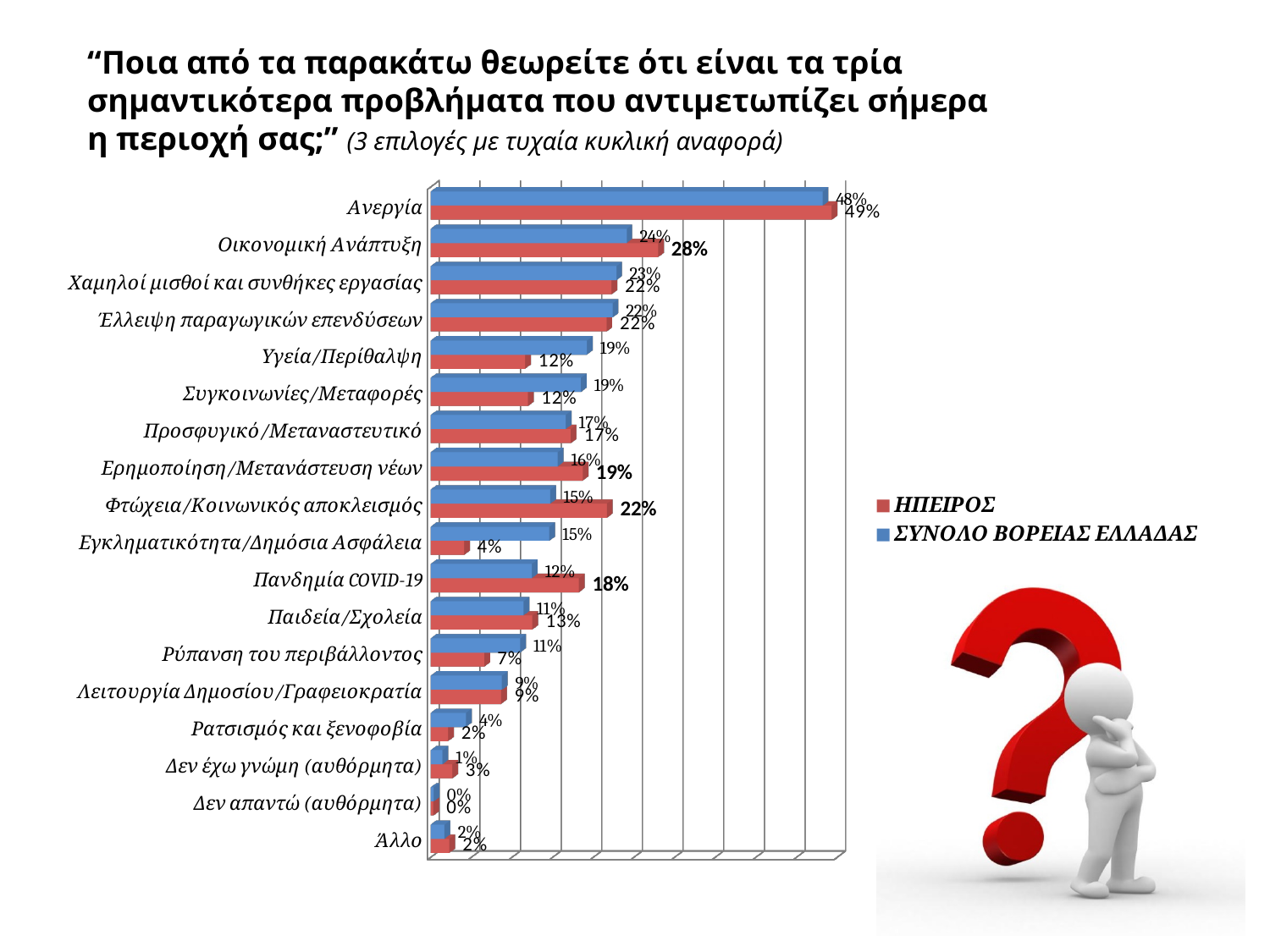
What is the value for ΗΠΕΙΡΟΣ for Ανεργία? 49% What is the value for ΣΥΝΟΛΟ ΒΟΡΕΙΑΣ ΕΛΛΑΔΑΣ for Οικονομική Ανάπτυξη? 24% Which category has the highest value for ΣΥΝΟΛΟ ΒΟΡΕΙΑΣ ΕΛΛΑΔΑΣ? Ανεργία Which category has the lowest value for ΗΠΕΙΡΟΣ? Δεν απαντώ (αυθόρμητα) What kind of chart is shown on the slide? Bar chart What is the difference between the ΗΠΕΙΡΟΣ and ΣΥΝΟΛΟ ΒΟΡΕΙΑΣ ΕΛΛΑΔΑΣ values for Υγεία/Περίθαλψη? 7% How many categories are shown on the chart? 18 What is the difference between the ΗΠΕΙΡΟΣ and ΣΥΝΟΛΟ ΒΟΡΕΙΑΣ ΕΛΛΑΔΑΣ values for Πανδημία COVID-19? 6% What is the value for ΗΠΕΙΡΟΣ for Εγκληματικότητα/Δημόσια Ασφάλεια? 4% For Εγκληματικότητα/Δημόσια Ασφάλεια, which series has the larger value, ΗΠΕΙΡΟΣ or ΣΥΝΟΛΟ ΒΟΡΕΙΑΣ ΕΛΛΑΔΑΣ? ΣΥΝΟΛΟ ΒΟΡΕΙΑΣ ΕΛΛΑΔΑΣ What is the value for ΗΠΕΙΡΟΣ for Φτώχεια/Κοινωνικός αποκλεισμός? 22% How many series does the legend list? 2